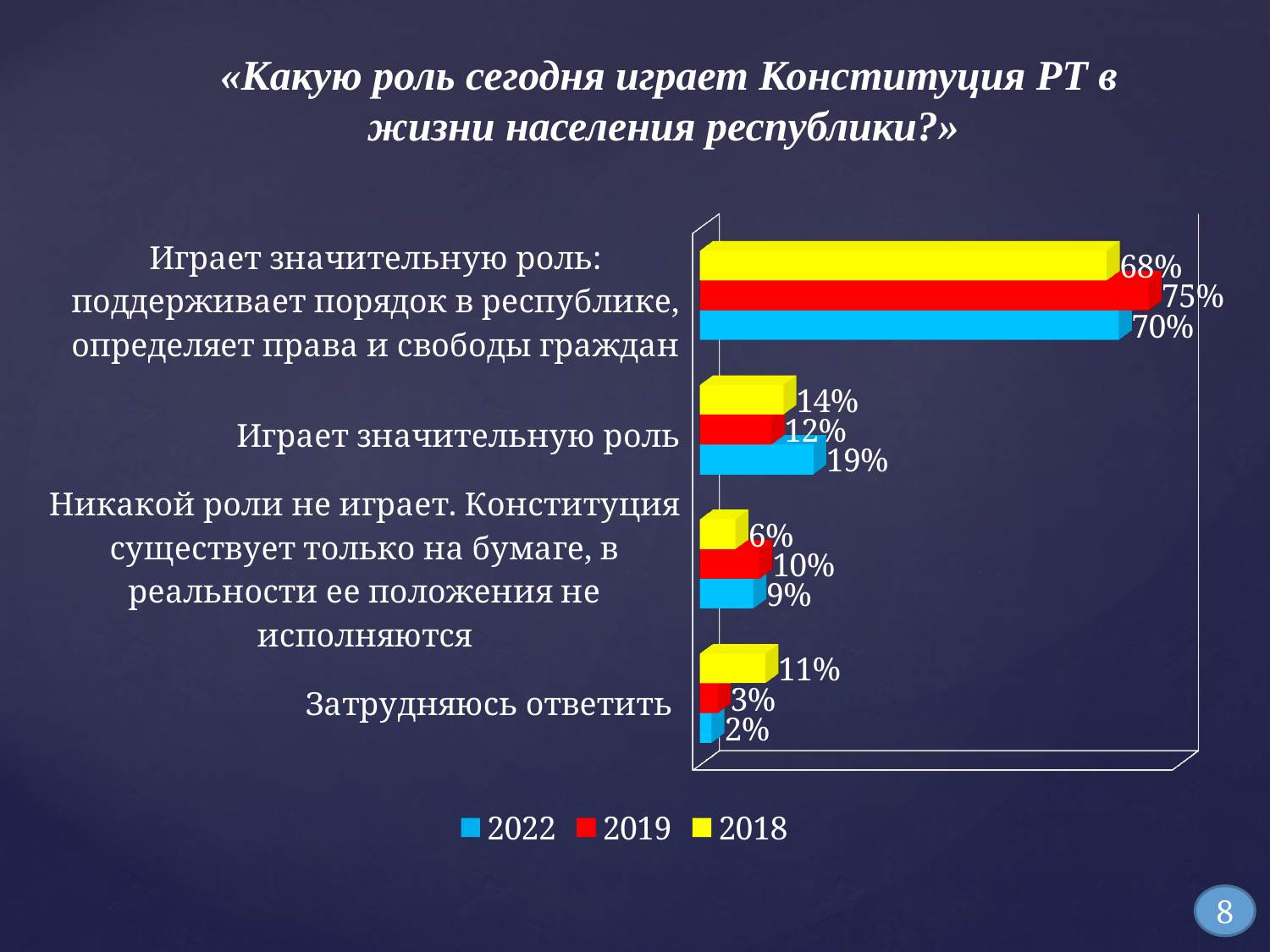
What is the 2018 value for the category "Затрудняюсь ответить"? 11% For the category "Играет значительную роль", which series has the larger value, 2022 or 2019? 2022 What is the difference between the 2019 and 2018 values for the category "Играет значительную роль: поддерживает порядок в республике, определяет права и свободы граждан"? 7% What is the 2022 value for the category "Играет значительную роль"? 19% How many categories are shown on the chart? 4 For the category "Затрудняюсь ответить", which series has the larger value, 2018 or 2019? 2018 What is the 2019 value for the category "Никакой роли не играет. Конституция существует только на бумаге, в реальности ее положения не исполняются"? 10% What is the 2019 value for the category "Играет значительную роль: поддерживает порядок в республике, определяет права и свободы граждан"? 75% Which category has the lowest value for the 2022 series? Затрудняюсь ответить Which category has the highest value for the 2022 series? Играет значительную роль: поддерживает порядок в республике, определяет права и свободы граждан How many series does the legend list? 3 What kind of chart is shown on the slide? Bar chart